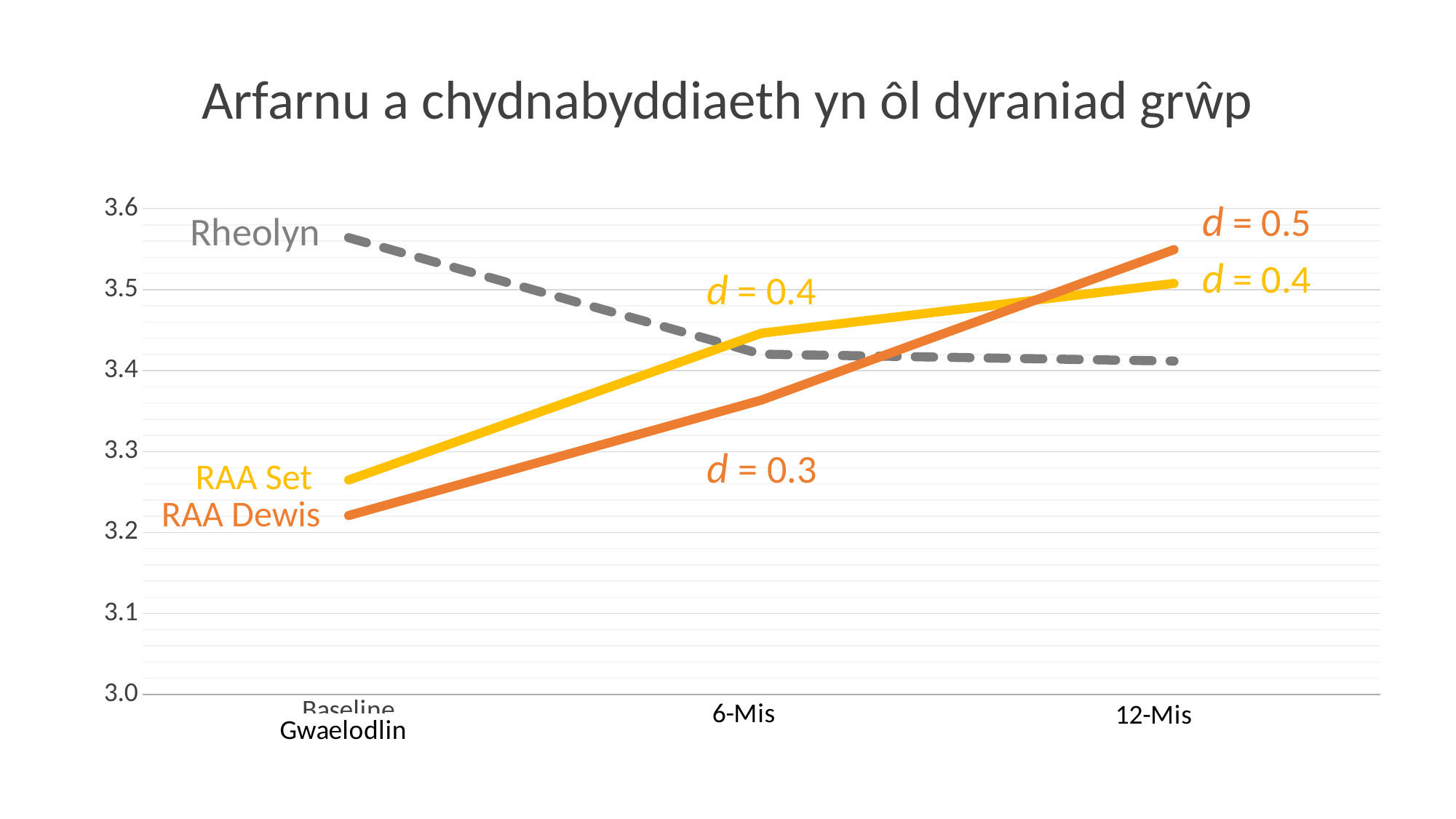
How many time points are shown on the x axis? 3 Does the Rheolyn line rise or fall from Gwaelodlin to 12-Mis? fall How many series (groups) are plotted on the chart? 3 What kind of chart is shown on the slide? line chart At Gwaelodlin, which is higher: Rheolyn or RAA Dewis? Rheolyn Is the value for RAA Set at Gwaelodlin greater or less than 3.3? less Which group has the highest value at 12-Mis? RAA Dewis Does the RAA Dewis line rise or fall from Gwaelodlin to 12-Mis? rise Is the value for RAA Dewis at 12-Mis greater or less than 3.5? greater Is the value for Rheolyn at Gwaelodlin greater or less than 3.5? greater Which group has the lowest value at Gwaelodlin? RAA Dewis What effect size (d) is printed next to the RAA Dewis line at 12-Mis? d = 0.5